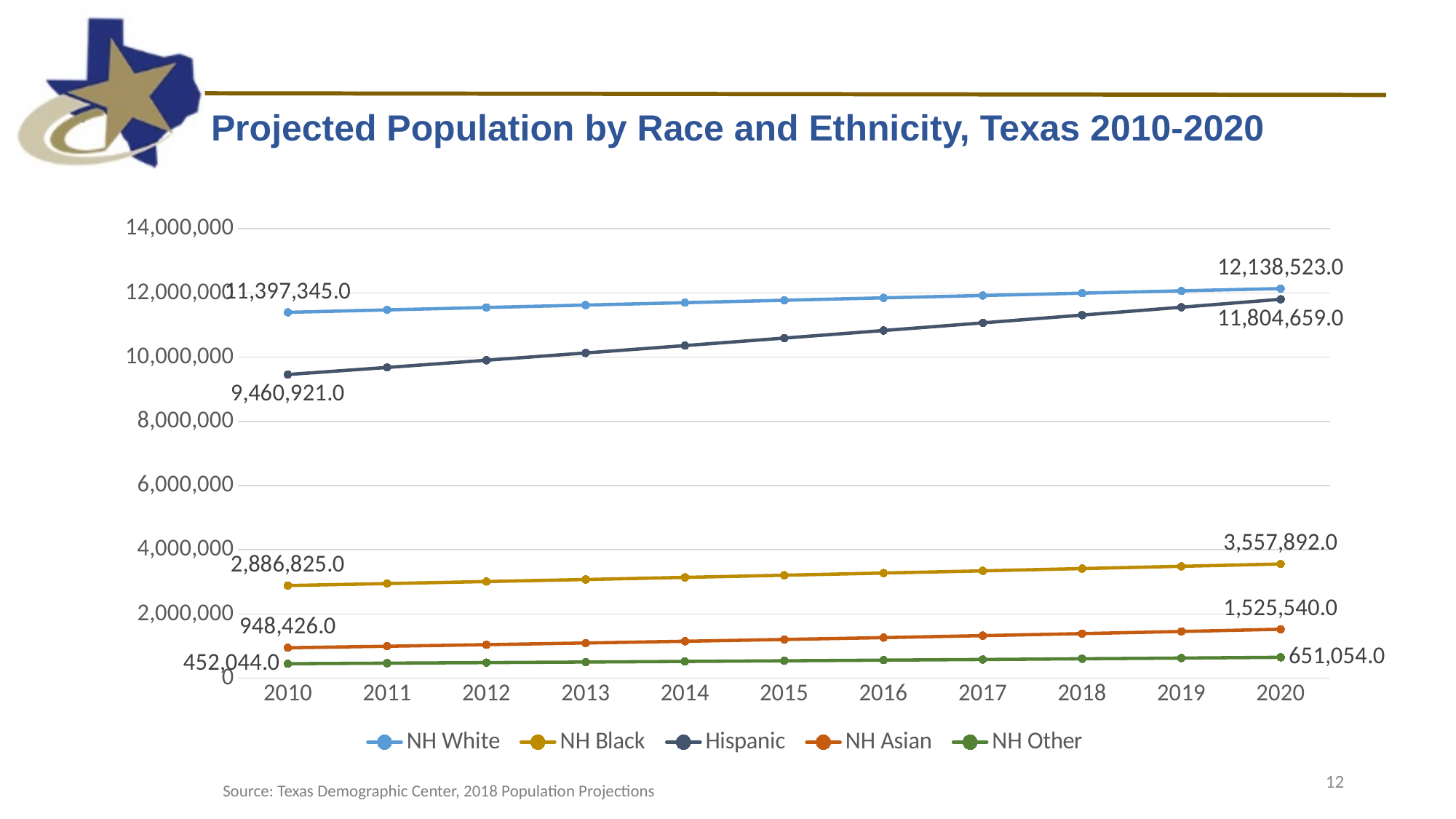
Which group has the lowest projected population in 2020? NH Other What is the projected NH White population in 2020? 12,138,523.0 What is the NH Asian population value shown for 2010? 948,426.0 By how much does the Hispanic population increase from 2010 to 2020? 2,343,738.0 What is the NH Other population value shown for 2020? 651,054.0 Is the Hispanic population value for 2015 greater or less than 10,000,000? greater What kind of chart is shown on the slide? Line chart What is the NH Black population value shown for 2020? 3,557,892.0 How many series does the legend list? 5 What is the Hispanic population value shown for 2010? 9,460,921.0 Which group has the highest projected population in 2010? NH White Which is larger in 2020, the NH White population or the Hispanic population? NH White